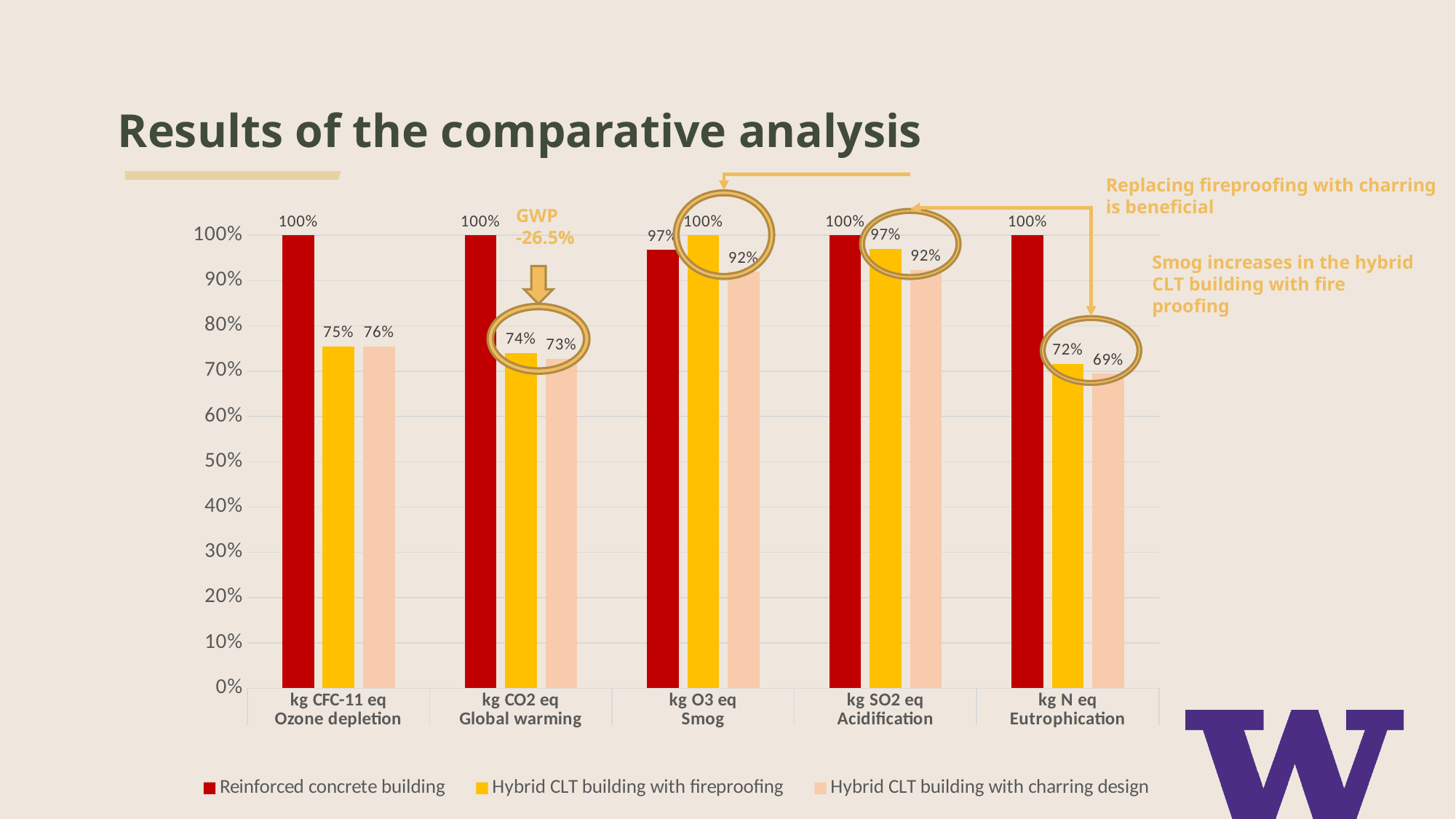
What is the value for the Hybrid CLT building with charring design in the Eutrophication category? 69% How many series does the legend list? 3 In the Smog category, which is larger: the Reinforced concrete building or the Hybrid CLT building with fireproofing? Hybrid CLT building with fireproofing What kind of chart is shown on the slide? bar chart What is the value for the Hybrid CLT building with charring design in the Acidification category? 92% What is the value for the Hybrid CLT building with fireproofing in the Global warming category? 74% What is the value for the Reinforced concrete building in the Smog category? 97% What is the difference between the Reinforced concrete building and the Hybrid CLT building with charring design in the Ozone depletion category? 24% Is the value for the Hybrid CLT building with fireproofing in the Eutrophication category greater or less than 80%? less How many impact categories are shown on the x axis? 5 In which category does the Hybrid CLT building with charring design have its highest value? Smog and Acidification (tied at 92%) In which category does the Hybrid CLT building with fireproofing have its lowest value? Eutrophication